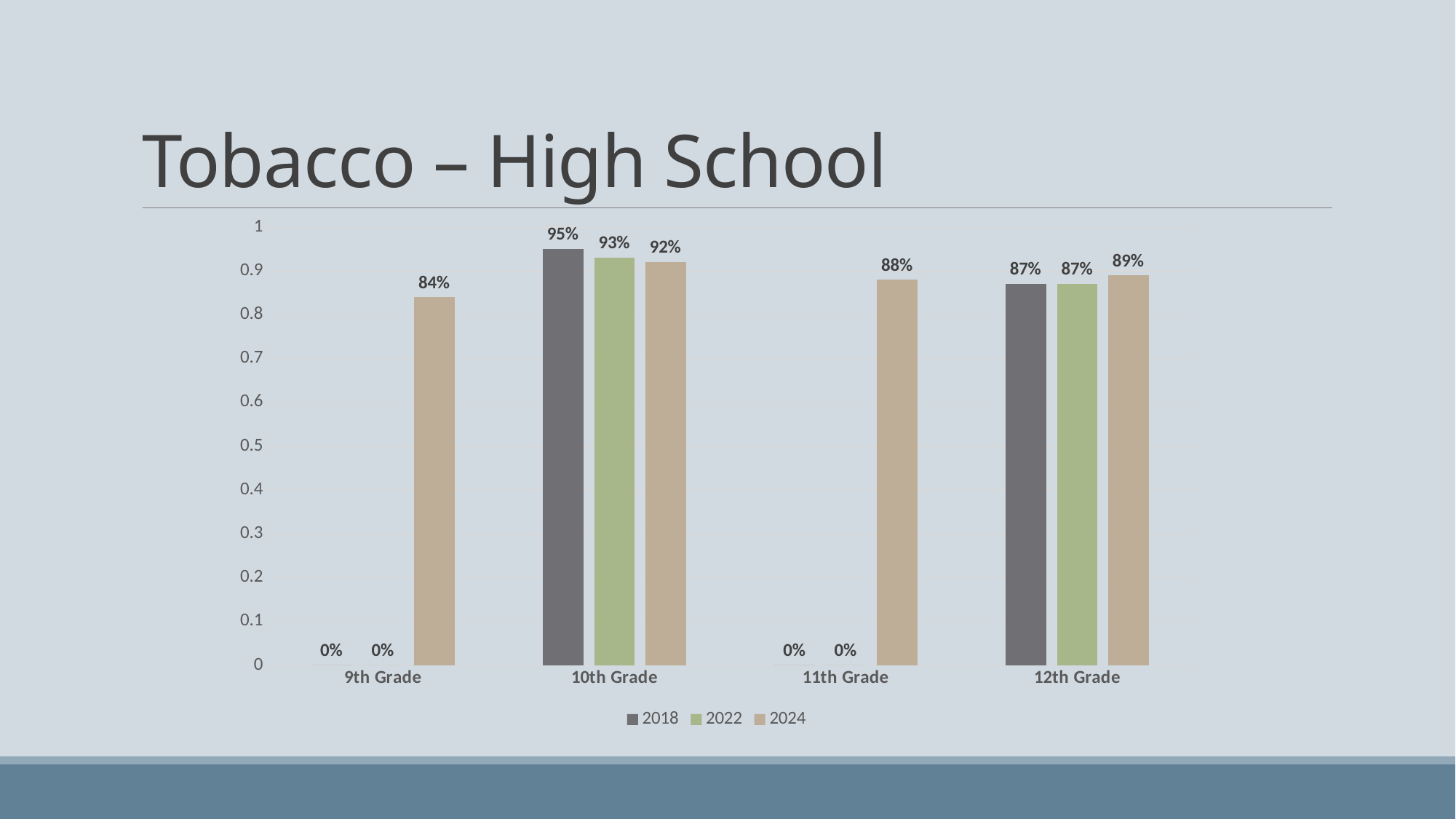
What kind of chart is shown on the slide? Bar chart How many series does the legend list? 3 Which grade has the lowest value in the 2024 series? 9th Grade What is the value for 12th Grade in the 2022 series? 87% How many grade categories are shown on the x axis? 4 What is the value for 11th Grade in the 2024 series? 88% Which grade has the highest value in the 2024 series? 10th Grade What is the value for 10th Grade in the 2018 series? 95% Which is larger for 12th Grade: the 2018 value or the 2024 value? 2024 What is the title of the slide? Tobacco – High School What is the value for 9th Grade in the 2024 series? 84% What is the difference between the 2018 and 2024 values for 10th Grade? 3%